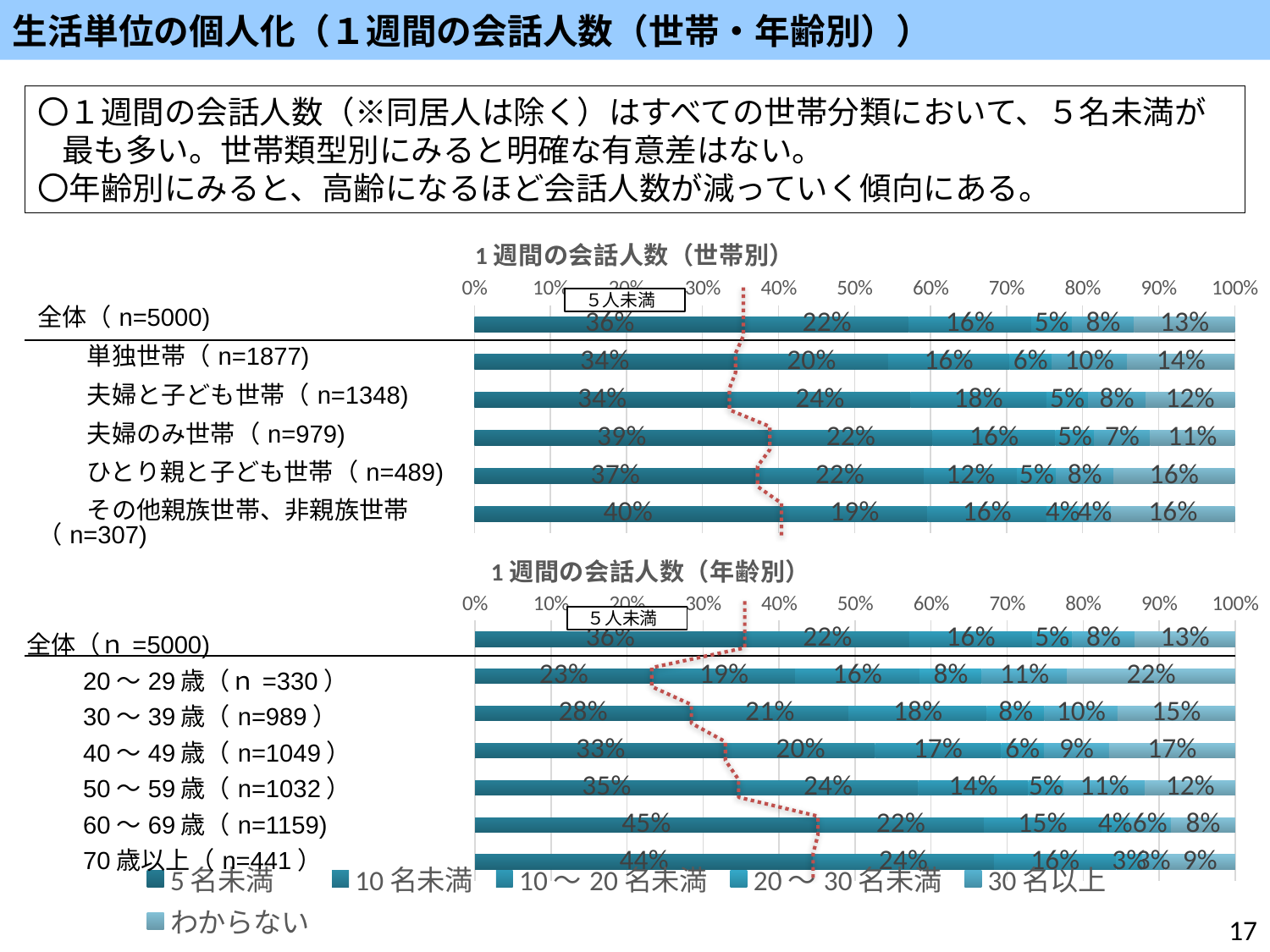
What kind of chart is 1週間の会話人数（世帯別）? stacked bar chart In the chart titled 1週間の会話人数（世帯別）, what is the value of 5名未満 for 夫婦のみ世帯? 39% In the chart titled 1週間の会話人数（世帯別）, what is the わからない value for ひとり親と子ども世帯? 16% In the chart titled 1週間の会話人数（年齢別）, what is the difference between the 5名未満 values for 50～59歳 and 30～39歳? 7% In the chart titled 1週間の会話人数（年齢別）, what is the 5名未満 value for 60～69歳? 45% In the chart titled 1週間の会話人数（世帯別）, what is the difference between the 5名未満 values for 夫婦のみ世帯 and 単独世帯? 5% In the chart titled 1週間の会話人数（年齢別）, how many age-group categories are plotted, excluding 全体? 6 In the chart titled 1週間の会話人数（年齢別）, which is larger, the わからない value for 20～29歳 or for 60～69歳? 20～29歳 In the chart titled 1週間の会話人数（世帯別）, which household category has the highest 5名未満 share? その他親族世帯、非親族世帯 In the chart titled 1週間の会話人数（年齢別）, does the 5名未満 share generally rise or fall as age increases from 20～29歳 to 60～69歳? rise How many series does the legend list for the charts on this slide? 6 In the chart titled 1週間の会話人数（年齢別）, which age group has the lowest 5名未満 share? 20～29歳